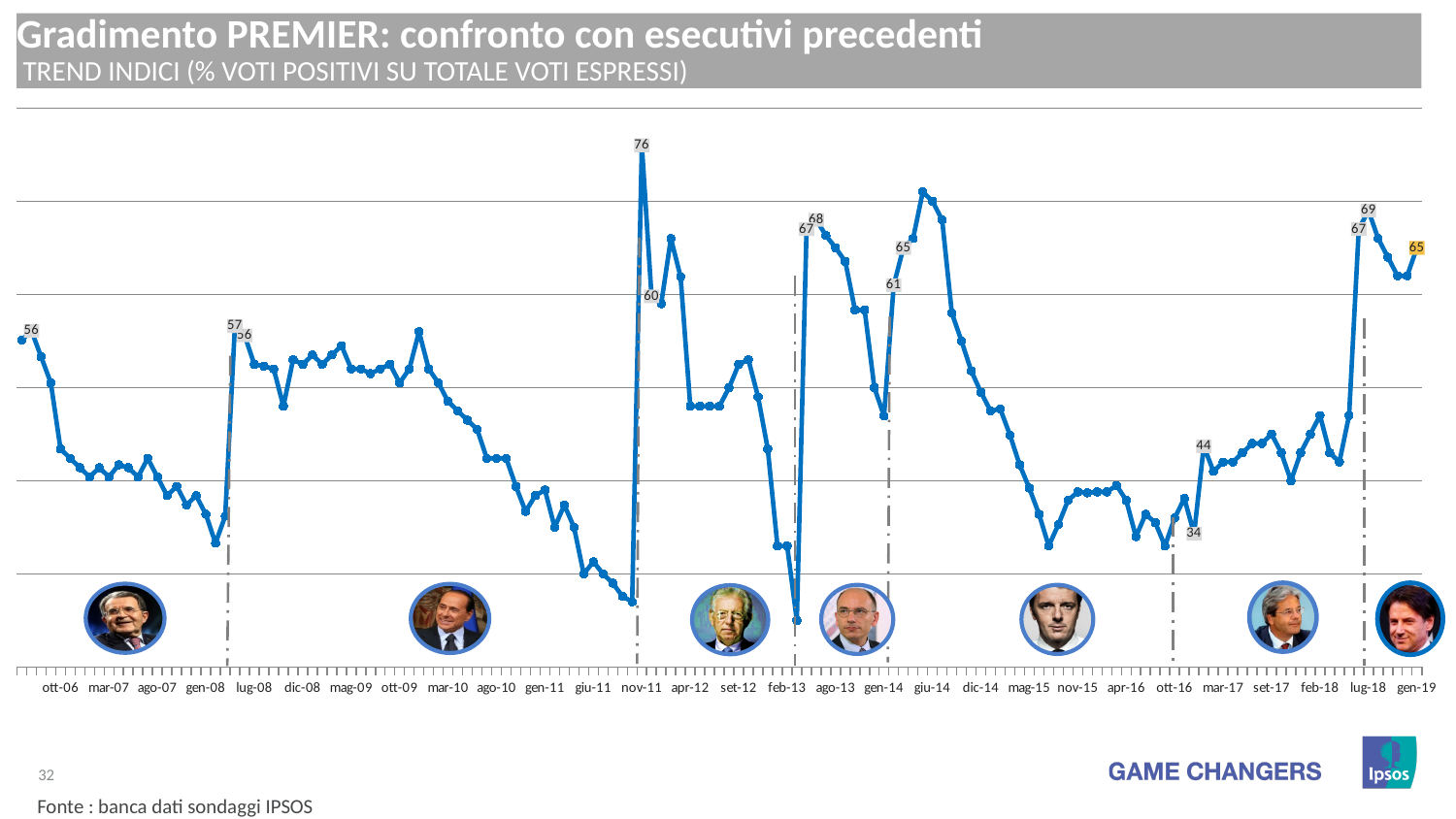
What is the title of the chart on the slide? Gradimento PREMIER: confronto con esecutivi precedenti Which is larger: the peak labelled 76 around nov-11 or the peak labelled 69 around lug-18? 76 What is the lowest labelled value on the line? 34 What is the highest labelled value on the line? 76 How many data series are plotted on the chart? 1 What source is cited at the bottom of the slide? banca dati sondaggi IPSOS What is the value of the first data point, at ott-06? 56 What kind of chart is shown on the slide? line chart What is the difference between the labelled values 69 and 67 near lug-18? 2 What is the difference between the highest labelled value (76) and the lowest labelled value (34)? 42 What is the value of the last data point, at gen-19 (highlighted in yellow)? 65 Does the line rise or fall from the peak of 69 near lug-18 to the final point at gen-19? fall